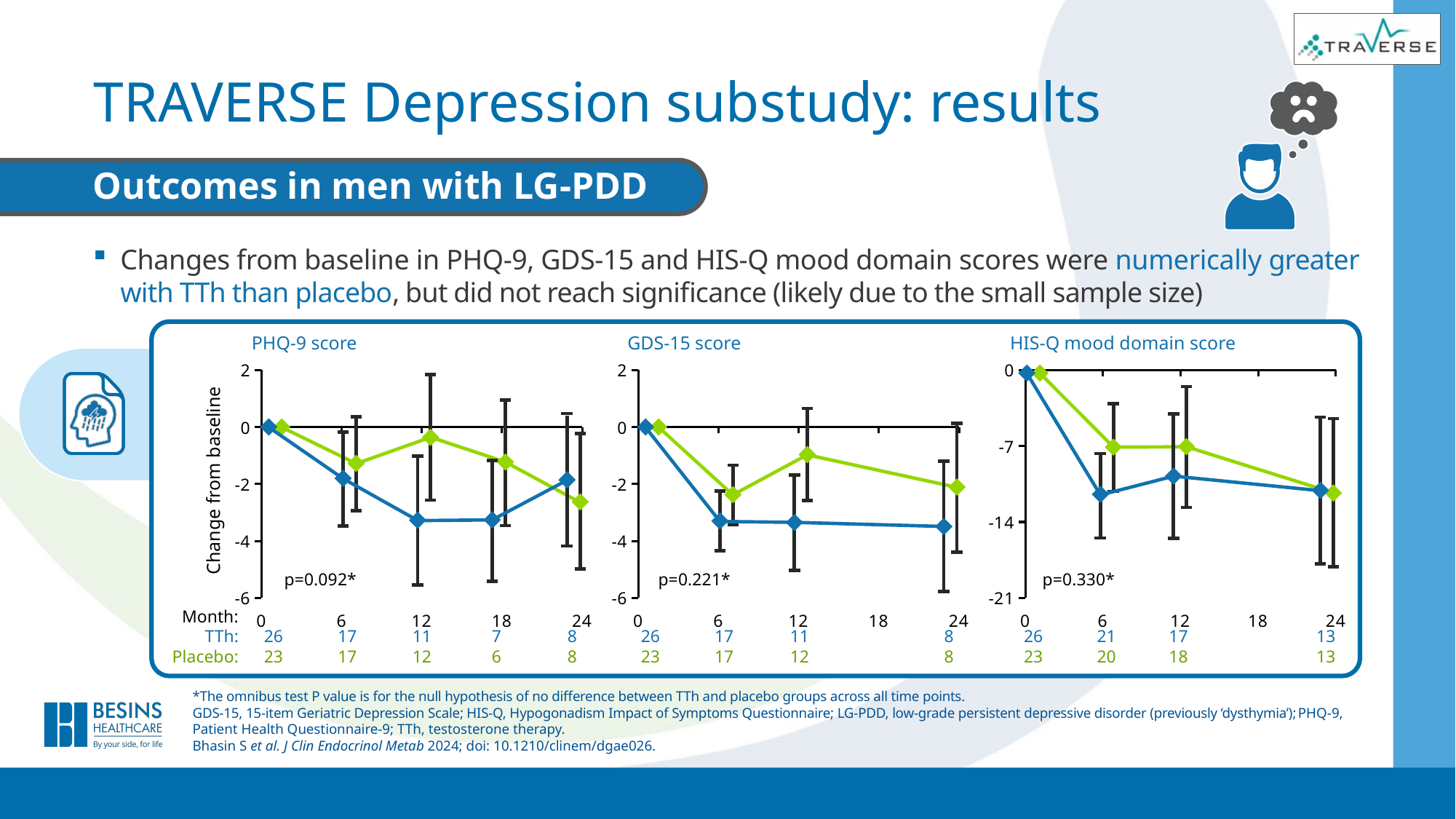
In the HIS-Q mood domain score chart, is the TTh value at month 6 greater or less than -7? less What p-value is printed on the PHQ-9 score chart? p=0.092* In the HIS-Q mood domain score chart, does the placebo line rise or fall from month 0 to month 24? fall In the PHQ-9 score chart, which group has the lower change from baseline at month 12, TTh or placebo? TTh What is the y-axis label shown for the charts? Change from baseline In the PHQ-9 score chart, what is the TTh sample size listed at month 24? 8 What p-value is printed on the HIS-Q mood domain score chart? p=0.330* In the GDS-15 score chart, is the placebo value at month 12 greater or less than -2? greater In the PHQ-9 score chart, is the TTh value at month 12 greater or less than -2? less What kind of chart is used for the PHQ-9 score panel? line chart In the GDS-15 score chart, which group has the lower change from baseline at month 24, TTh or placebo? TTh How many charts are shown in the boxed panel on the slide? 3